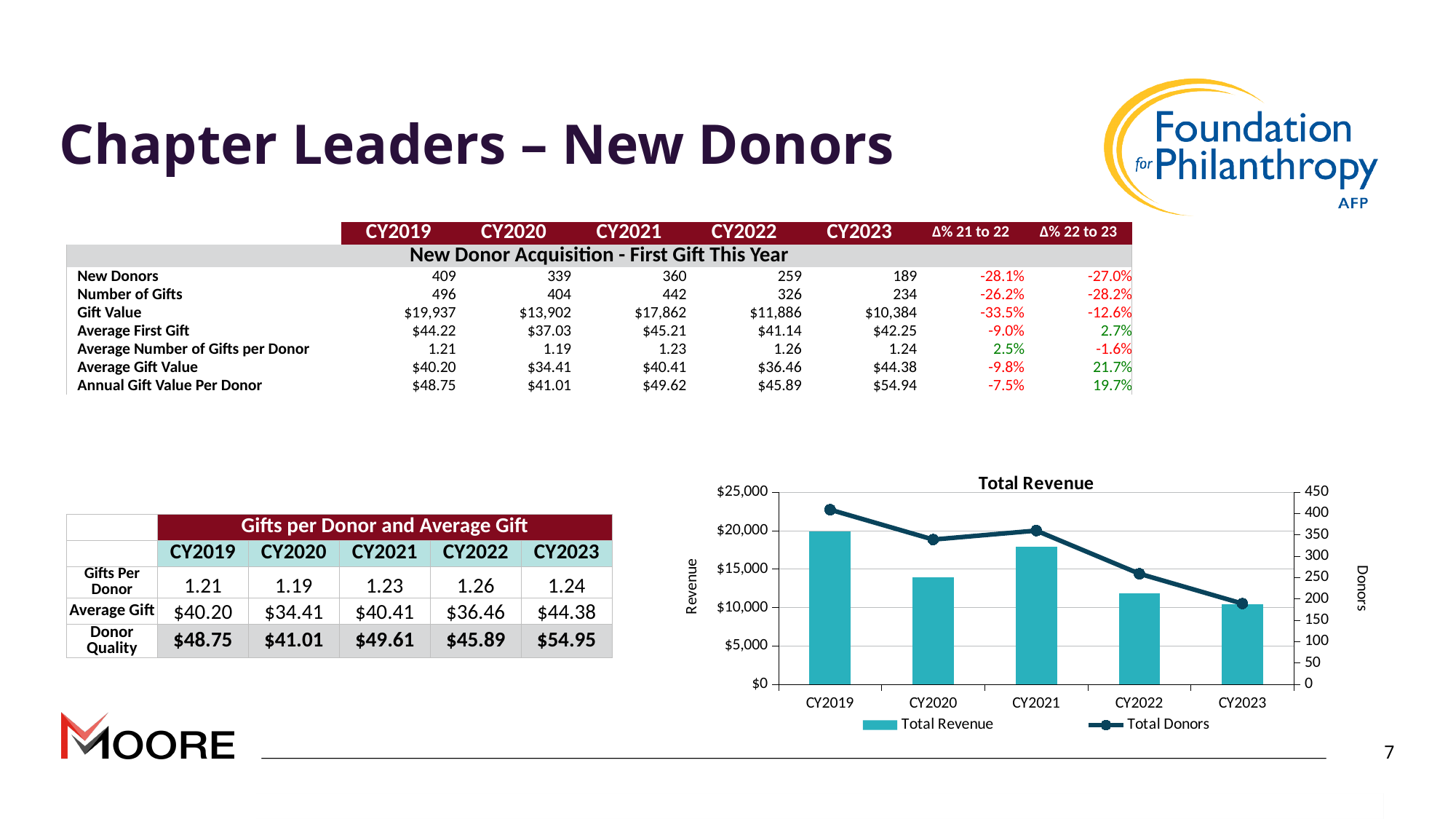
In the Total Revenue chart, which year has the lowest Total Donors value? CY2023 In the Total Revenue chart, which year has the lowest Total Revenue bar? CY2023 In the Total Revenue chart, which year has the highest Total Revenue bar? CY2019 In the Total Revenue chart, what kind of chart is used to show Total Revenue? Bar chart In the Total Revenue chart, is the Total Revenue for CY2022 greater or less than $15,000? less In the Total Revenue chart, is the Total Donors value for CY2022 greater or less than 200? greater In the Total Revenue chart, which year has the larger Total Revenue bar, CY2020 or CY2021? CY2021 In the Total Revenue chart, what is the label on the right-hand vertical axis? Donors How many series does the legend of the Total Revenue chart list? 2 How many years are shown on the x axis of the Total Revenue chart? 5 What is the title of the chart on the slide? Total Revenue In the Total Revenue chart, is the Total Revenue for CY2019 greater or less than $15,000? greater